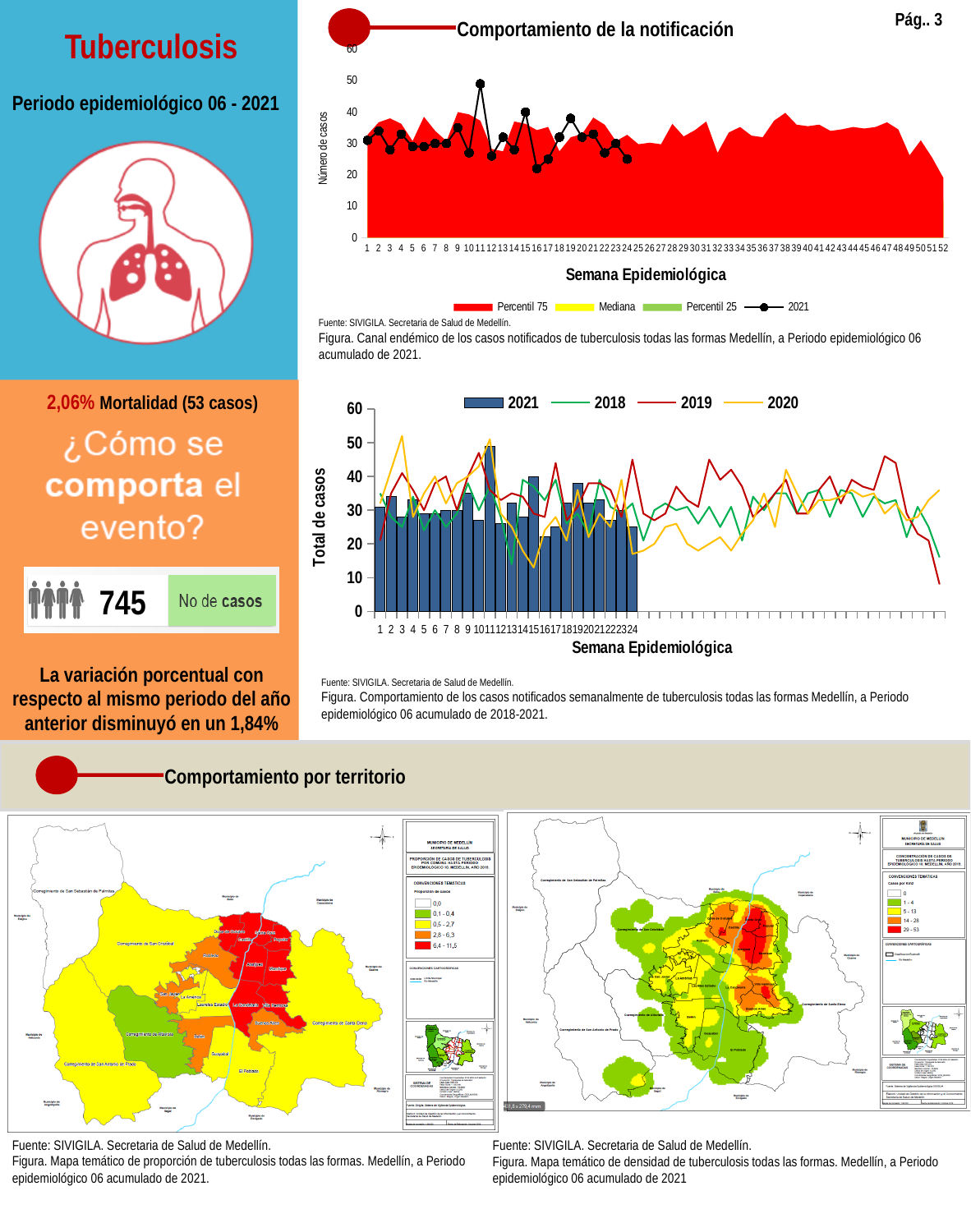
In the chart titled 'Comportamiento de la notificación', is the 2021 value for week 16 greater or less than 30? less In the second chart (Total de casos by Semana Epidemiológica), which week has the highest 2021 bar? 11 In the chart titled 'Comportamiento de la notificación', how many series does the legend list? 4 In the second chart (Total de casos by Semana Epidemiológica), is the 2021 value for week 16 greater or less than 30? less In the chart titled 'Comportamiento de la notificación', is the 2021 value for week 11 greater or less than 40? greater In the second chart (Total de casos by Semana Epidemiológica), which series is shown as bars? 2021 In the chart titled 'Comportamiento de la notificación', what is the label of the y axis? Número de casos In the second chart (Total de casos by Semana Epidemiológica), how many series does the legend list? 4 In the chart titled 'Comportamiento de la notificación', at which week does the 2021 line reach its highest value? 11 In the chart titled 'Comportamiento de la notificación', which colour represents Percentil 75? Red In the second chart (Total de casos by Semana Epidemiológica), how many weeks have a 2021 bar? 24